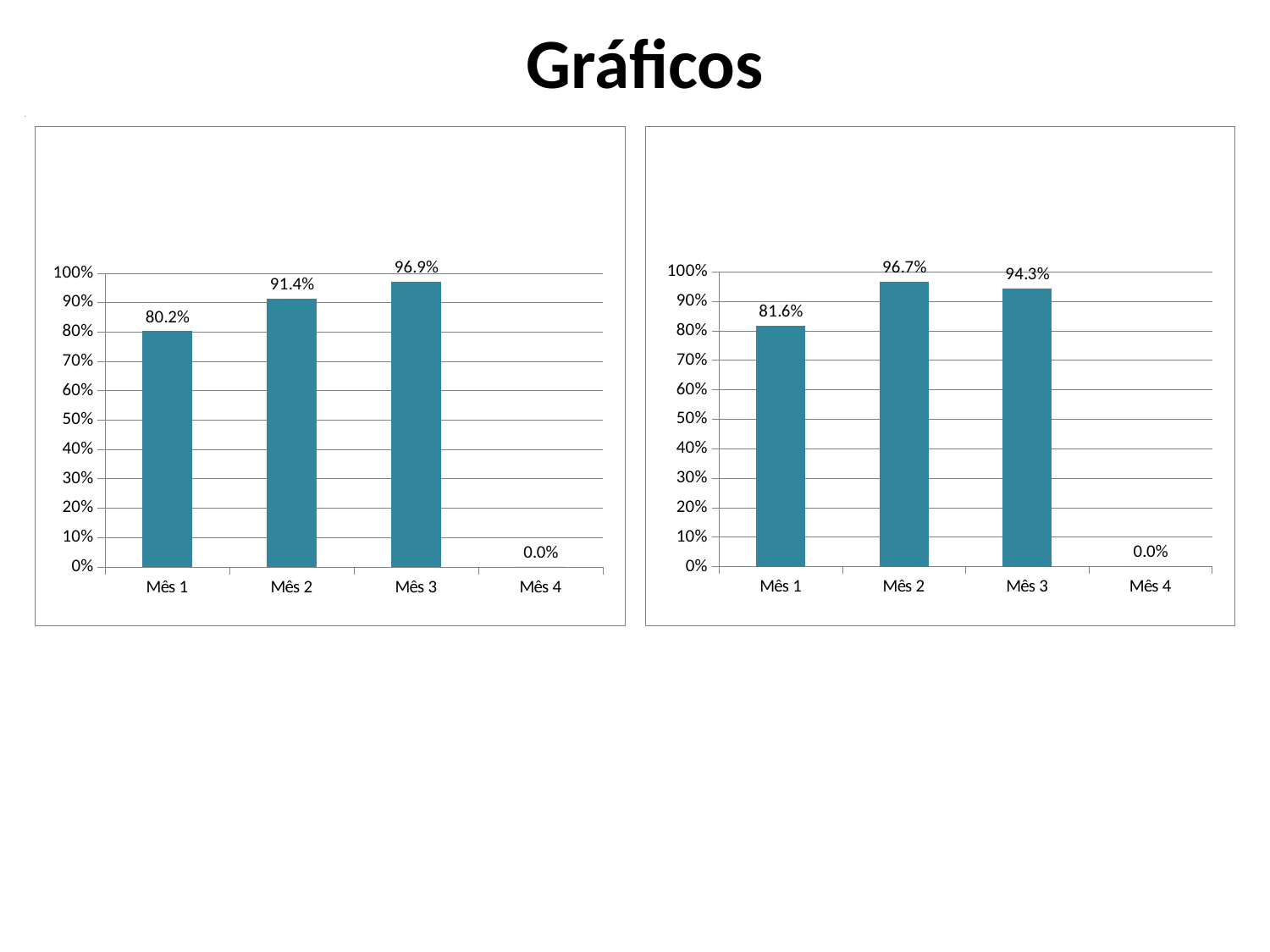
How many categories are shown on the x axis of the right chart? 4 In the left chart, which month has the highest value? Mês 3 What kind of chart is the left chart? bar chart In the right chart, which month has the highest value? Mês 2 In the right chart, which is larger, the value for Mês 1 or Mês 3? Mês 3 In the left chart, what is the difference between the values for Mês 3 and Mês 1? 16.7% In the right chart, what is the value for Mês 2? 96.7% In the left chart, is the value for Mês 2 greater or less than 90%? greater In the left chart, which month has the lowest value? Mês 4 In the right chart, what is the value for Mês 4? 0.0% In the left chart, what is the value for Mês 1? 80.2% In the right chart, what is the difference between the values for Mês 2 and Mês 1? 15.1%